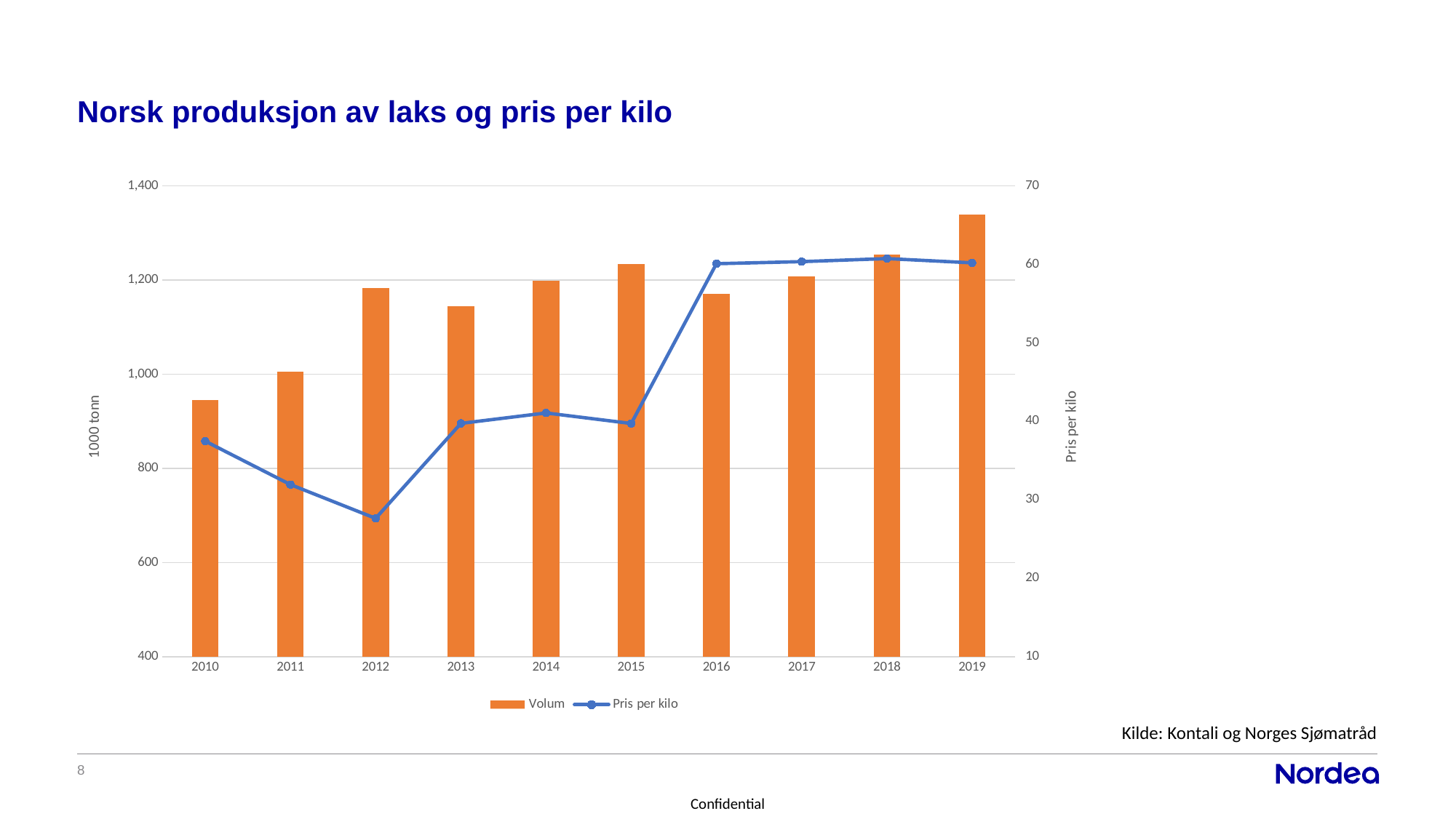
How many years are shown on the x axis? 10 Is the Volum value for 2010 greater or less than 1,000? less Which year has the highest Volum bar? 2019 Is the Pris per kilo value for 2016 greater or less than 50? greater In which year is Pris per kilo at its lowest? 2012 Which year has the lowest Volum bar? 2010 What type of chart is shown on the slide? Combined bar and line chart How many series does the legend list? 2 Is the Volum value for 2019 greater or less than 1,200? greater Which year has the larger Volum, 2015 or 2016? 2015 Does Pris per kilo rise or fall from 2010 to 2012? fall